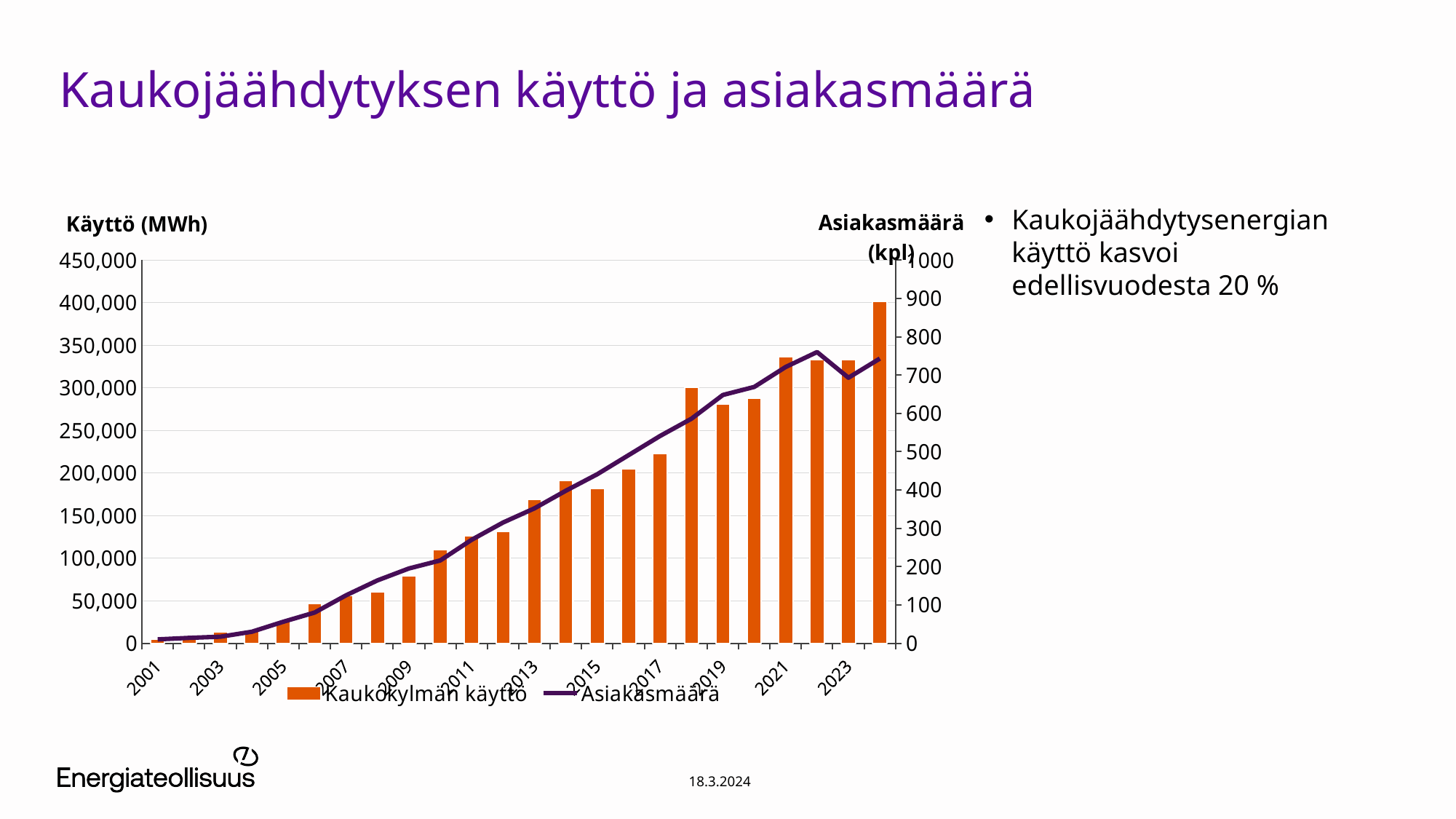
Is the Kaukokylmän käyttö value for 2023 greater or less than 300,000? greater What kind of chart is shown on the slide? Combined bar and line chart Is the Kaukokylmän käyttö value for 2009 greater or less than 100,000? less Is the Asiakasmäärä value for 2022 greater or less than 700? greater How many series does the chart's legend list? 2 Which is larger, the Kaukokylmän käyttö bar for 2021 or for 2019? 2021 What is the title of the chart on the slide? Kaukojäähdytyksen käyttö ja asiakasmäärä Overall, does the Asiakasmäärä line rise or fall from 2001 to 2024? rise Which year has the highest bar for Kaukokylmän käyttö? 2024 What is the label of the left vertical axis? Käyttö (MWh) Which year has the lowest bar for Kaukokylmän käyttö? 2001